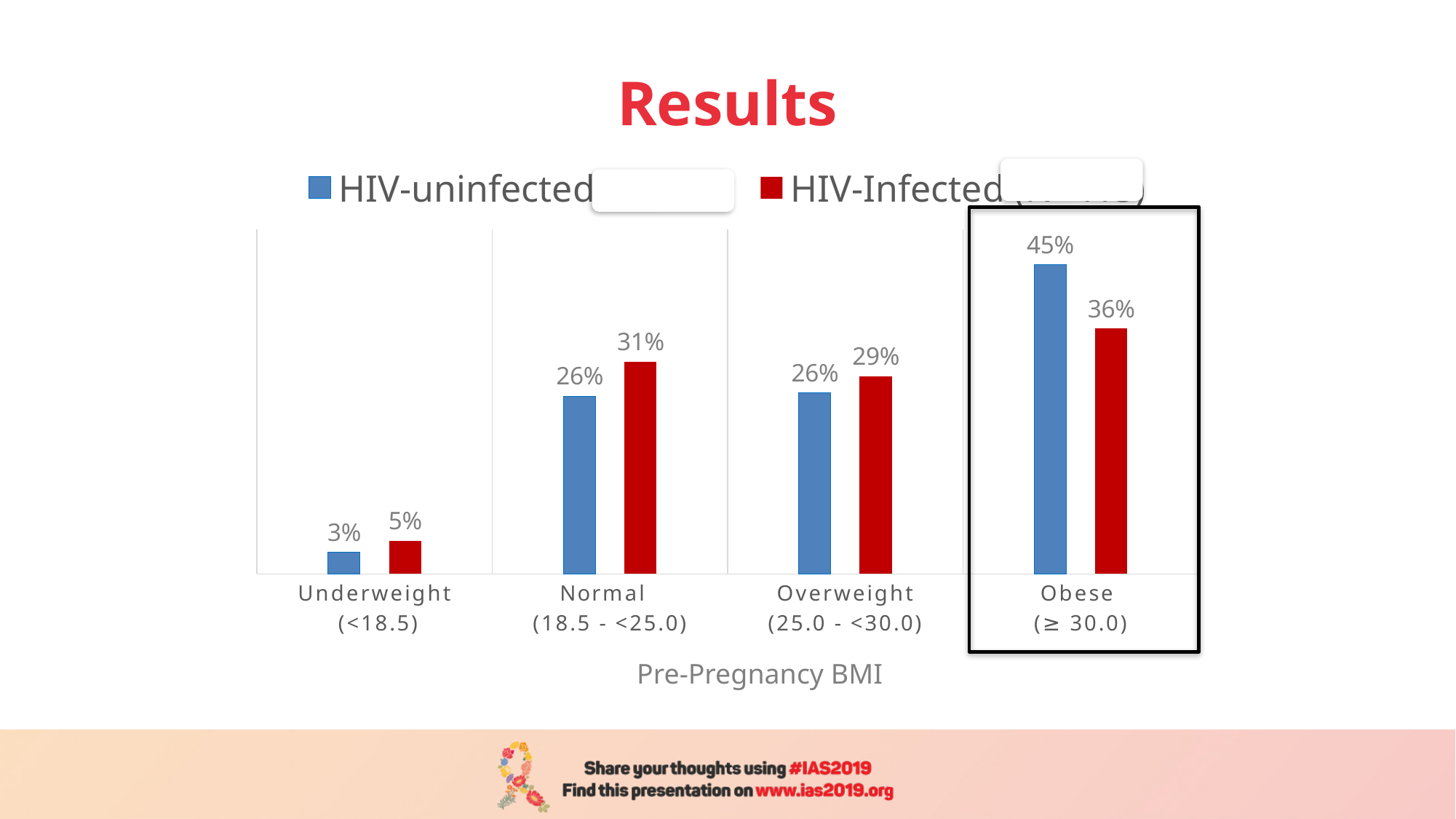
What is the x-axis title of the chart? Pre-Pregnancy BMI What is the value for HIV-Infected in the Underweight (<18.5) category? 5% How many BMI categories are shown on the x axis? 4 How many series does the legend list? 2 What is the value for HIV-uninfected in the Obese (≥ 30.0) category? 45% What is the difference between the HIV-uninfected and HIV-Infected values in the Obese (≥ 30.0) category? 9% What kind of chart is shown on the slide? Bar chart Which BMI category has the highest value for HIV-uninfected? Obese (≥ 30.0) In the Normal (18.5 - <25.0) category, which series has the larger value, HIV-uninfected or HIV-Infected? HIV-Infected What is the value for HIV-uninfected in the Overweight (25.0 - <30.0) category? 26% Which BMI category has the lowest value for HIV-Infected? Underweight (<18.5) What is the value for HIV-Infected in the Normal (18.5 - <25.0) category? 31%